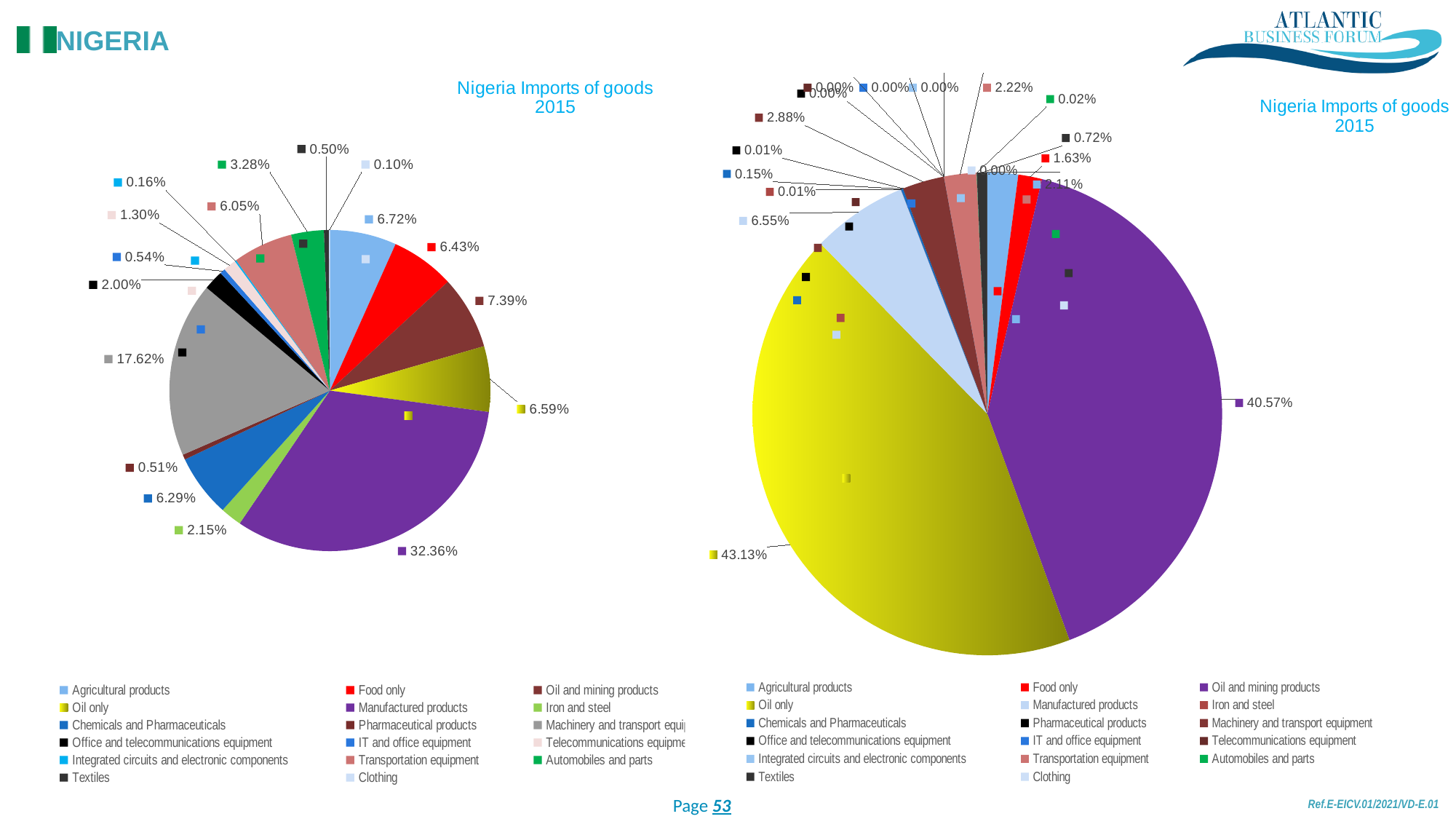
In the right pie chart, what is the value for Oil and mining products? 40.57% In the right pie chart, what is the difference between the shares of Oil only and Oil and mining products? 2.56% How many categories does the legend of the left pie chart list? 17 In the left pie chart, what is the value for Machinery and transport equipment? 17.62% In the right pie chart, which category has the largest share? Oil only In the left pie chart, what is the difference between the shares of Oil and mining products and Food only? 0.96% In the left pie chart, which category has the largest share? Manufactured products In the left pie chart, what share of Nigeria's imports of goods in 2015 is Manufactured products? 32.36% In the left pie chart, what is the value for Agricultural products? 6.72% In the left pie chart, which is larger: Chemicals and Pharmaceuticals or Transportation equipment? Chemicals and Pharmaceuticals In the right pie chart, what is the value for Oil only? 43.13% In the left pie chart, which category has the smallest share? Clothing